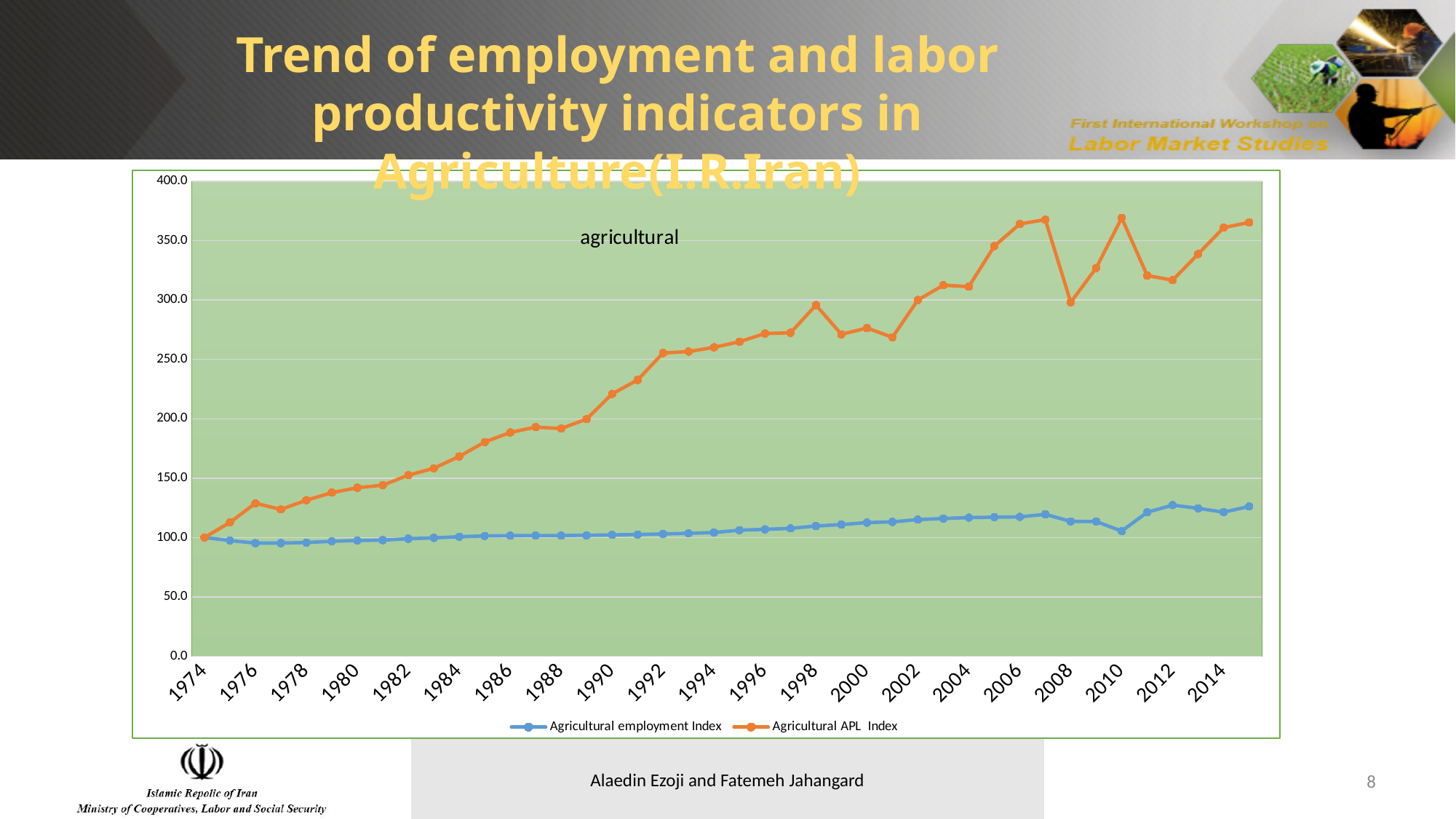
Which colour is used for the Agricultural APL Index line? Orange What is the value of the Agricultural employment Index in 1974? 100.0 Is the value of the Agricultural APL Index in 2014 greater or less than 300? greater Is the value of the Agricultural employment Index in 2010 greater or less than 150? less What is the value of the Agricultural APL Index in 1974? 100.0 What kind of chart is shown on the slide? Line chart Is the value of the Agricultural APL Index in 2006 greater or less than 350? greater Does the Agricultural APL Index generally rise or fall from 1974 to 2014? Rise How many series does the legend list? 2 In 2014, which series has the larger value, the Agricultural APL Index or the Agricultural employment Index? Agricultural APL Index What are the two series named in the legend? Agricultural employment Index and Agricultural APL Index